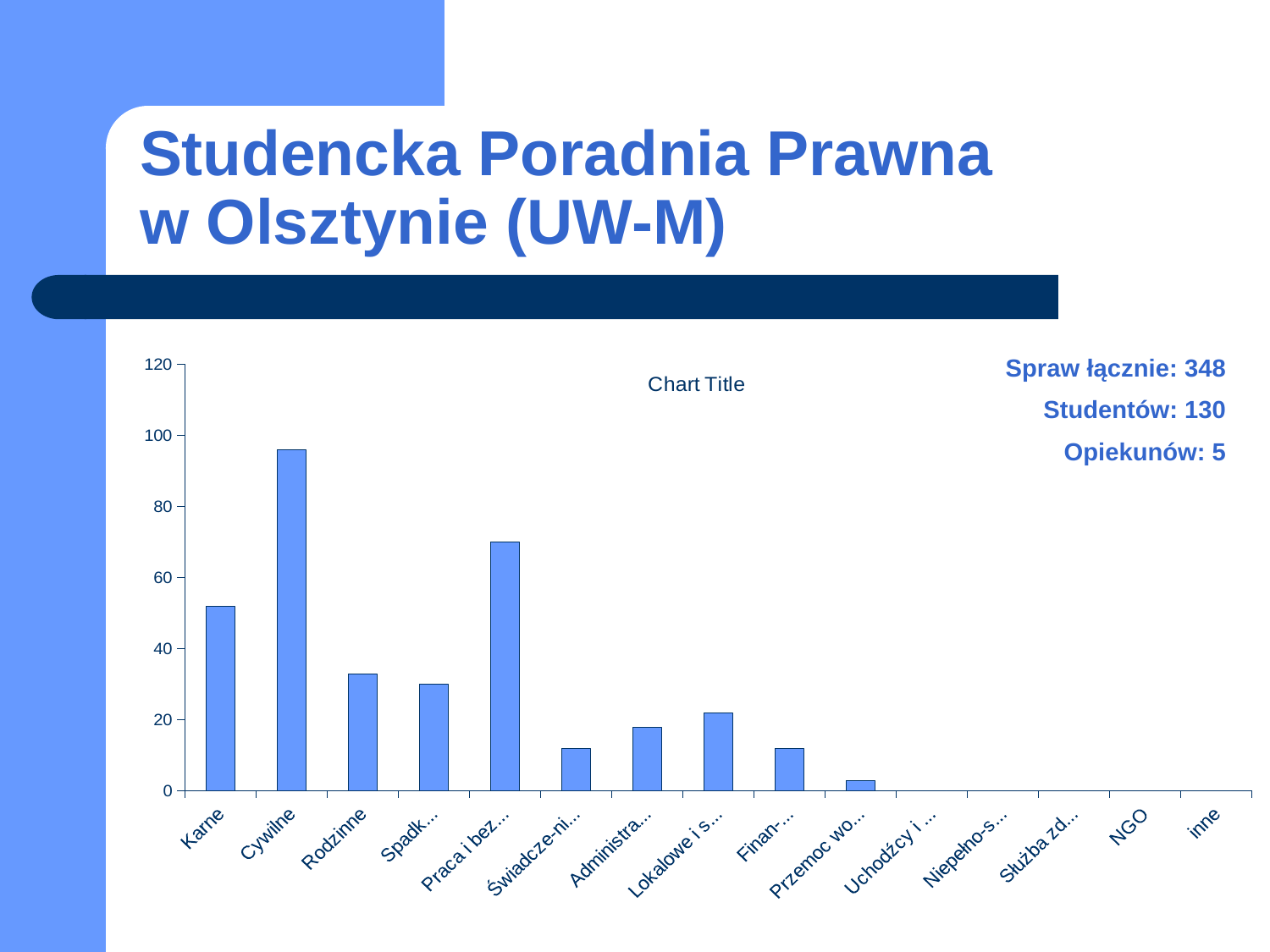
What is the title shown on the chart? Chart Title Is the value for Karne greater or less than 40? greater Is the value for Praca i bez... greater or less than 60? greater Is the value for Przemoc wo... greater or less than 20? less Which is larger, the value for Karne or the value for Rodzinne? Karne How many categories are shown on the x axis of the chart? 15 What kind of chart is shown on the slide? bar chart Which category has the tallest bar in the chart? Cywilne Which is larger, the value for Cywilne or the value for Praca i bez...? Cywilne